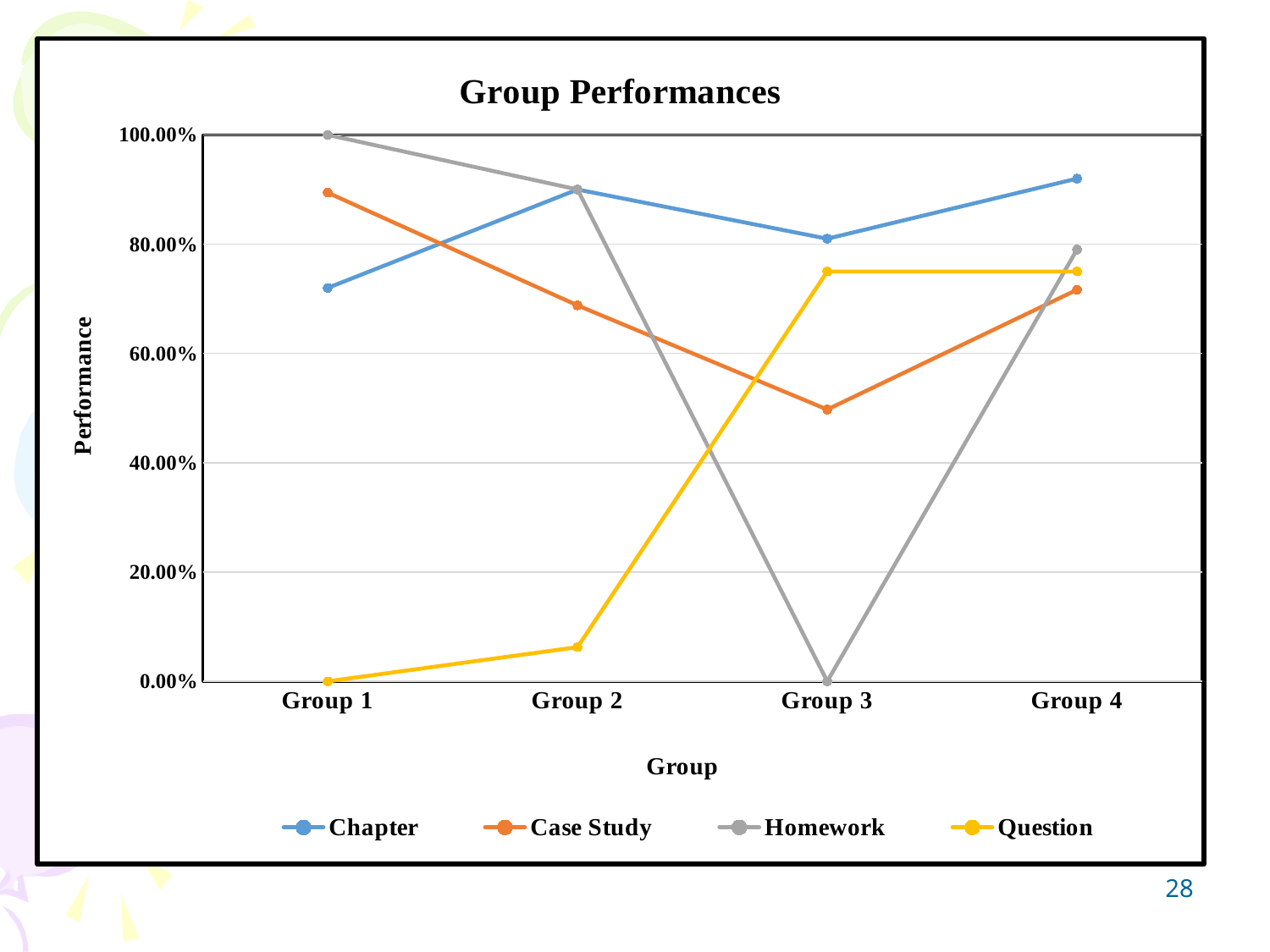
At Group 3, which series has the larger value, Chapter or Case Study? Chapter For which group is the Homework series highest? Group 1 What is the Homework value for Group 1? 100.00% For which group is the Homework series lowest? Group 3 What is the title of the chart? Group Performances What kind of chart is shown on the slide? Line chart What is the Homework value for Group 3? 0.00% Is the Chapter value for Group 1 greater or less than 80.00%? less How many series does the legend list? 4 Is the Question value for Group 2 greater or less than 20.00%? less What is the Question value for Group 1? 0.00% How many groups are plotted along the x axis? 4